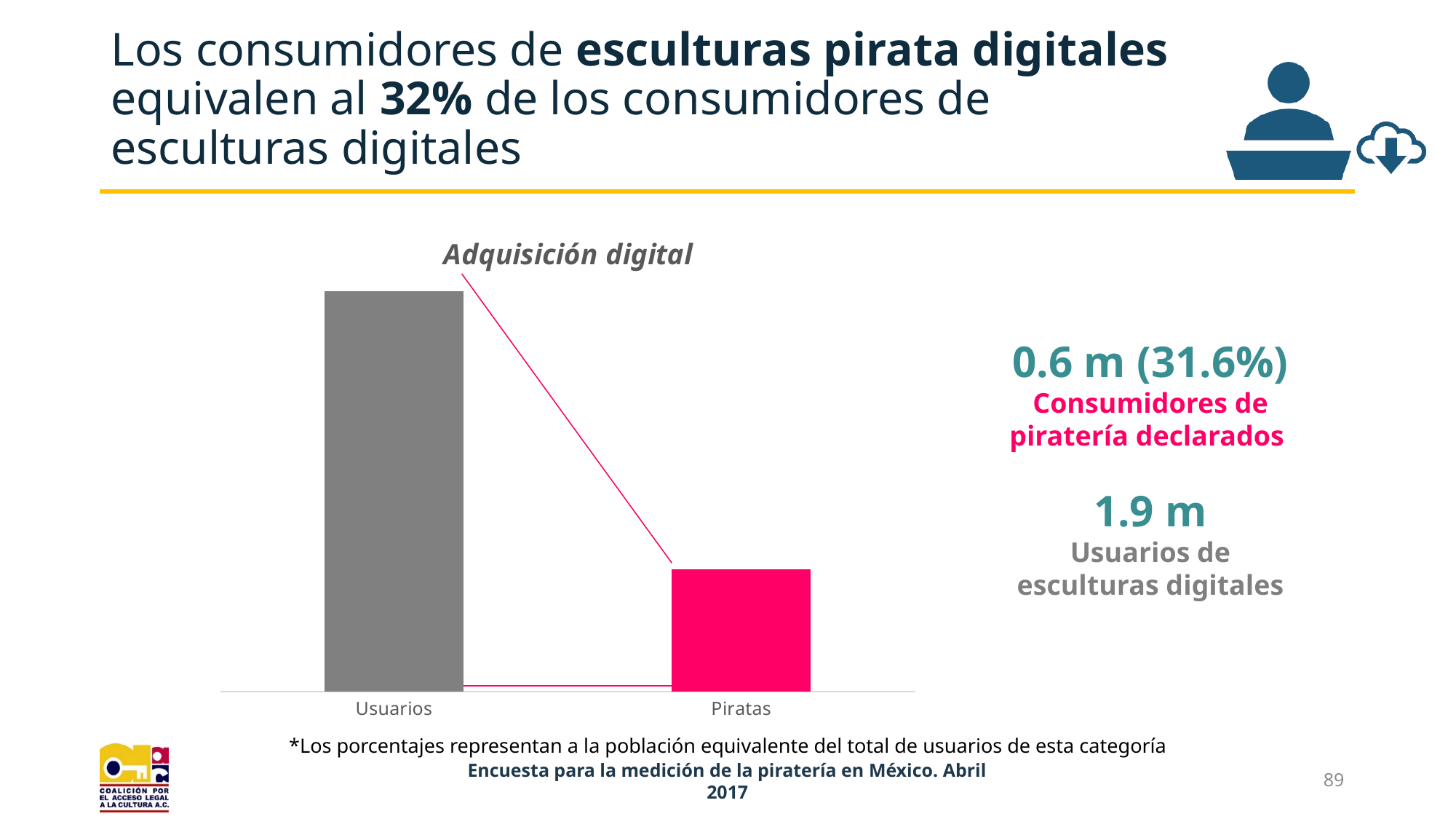
According to the figures printed beside the chart, how many users of digital sculptures (Usuarios de esculturas digitales) are there? 1.9 m Which category has the shortest bar in the chart? Piratas According to the figures printed beside the chart, how many declared piracy consumers (Consumidores de piratería declarados) are there? 0.6 m How many categories are shown on the x axis of the chart? 2 Do the bar values rise or fall from Usuarios to Piratas? Fall What percentage of users of digital sculptures do the declared piracy consumers represent, as printed beside the chart? 31.6% Which bar is taller, Usuarios or Piratas? Usuarios What colour is the Piratas bar in the chart? Pink Using the figures printed beside the chart, what is the difference between the number of Usuarios (1.9 m) and Piratas (0.6 m)? 1.3 m Which category has the tallest bar in the chart? Usuarios What kind of chart is shown on the slide? Bar chart What is the title of the chart? Adquisición digital